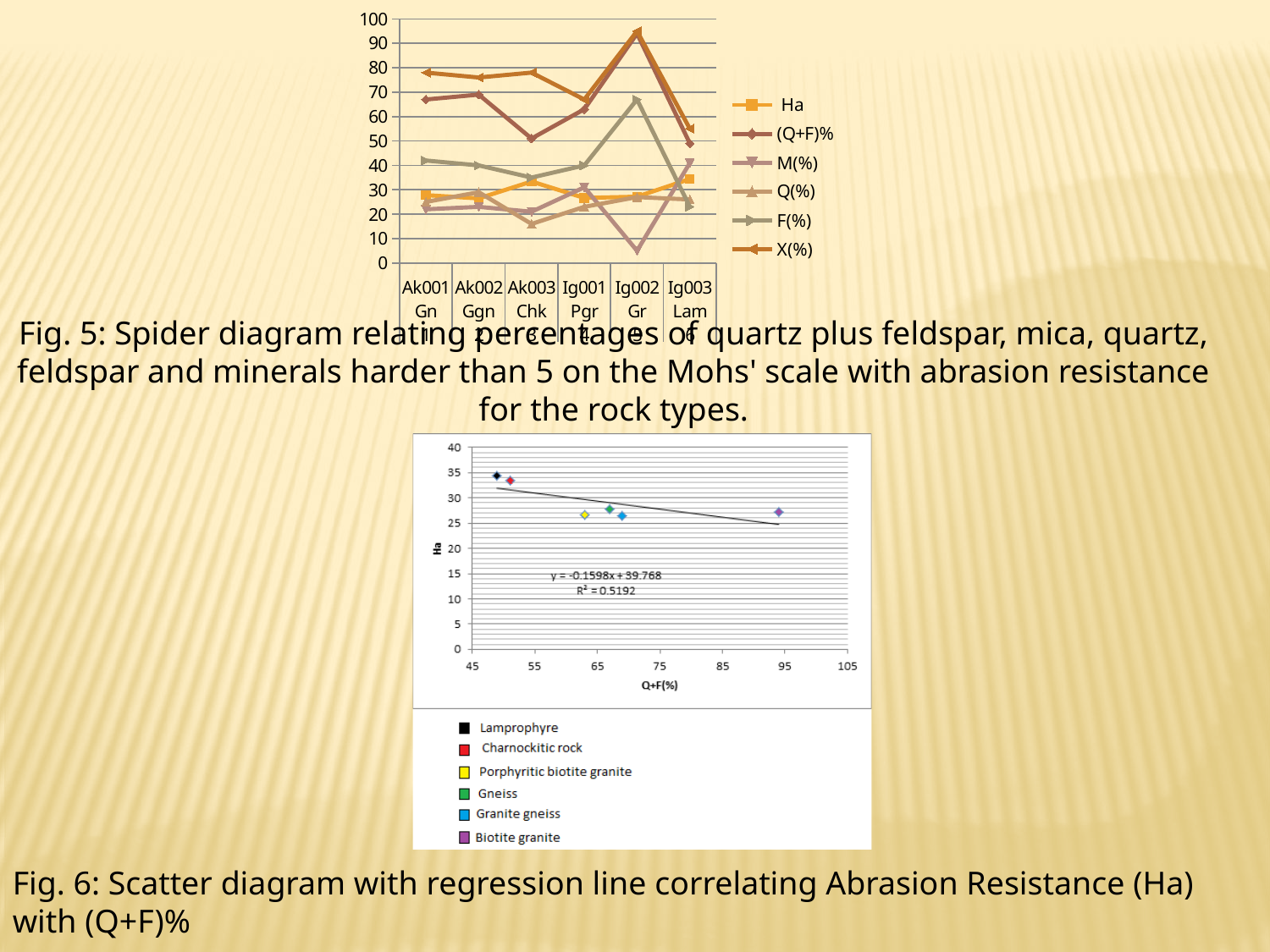
In the top chart (Fig. 5), is the X(%) value for Ak001 Gn greater or less than 70? greater What type of chart is the top chart (Fig. 5)? line chart In the top chart (Fig. 5), is the M(%) value for Ig002 Gr greater or less than 10? less In the top chart (Fig. 5), is the Q(%) value for Ak003 Chk greater or less than 20? less In the top chart (Fig. 5), which is larger at Ig002 Gr: the F(%) value or the Ha value? F(%) In the bottom chart (Fig. 6), does Ha rise or fall as (Q+F)% increases along the regression line? fall What type of chart is the bottom chart (Fig. 6)? scatter chart In the bottom chart (Fig. 6), what is the regression equation shown? y = -0.1598x + 39.768 How many rock-type categories are shown on the x axis of the top chart (Fig. 5)? 6 How many series does the legend of the top chart (Fig. 5) list? 6 In the top chart (Fig. 5), which category has the highest (Q+F)% value? Ig002 Gr In the top chart (Fig. 5), which category has the lowest M(%) value? Ig002 Gr